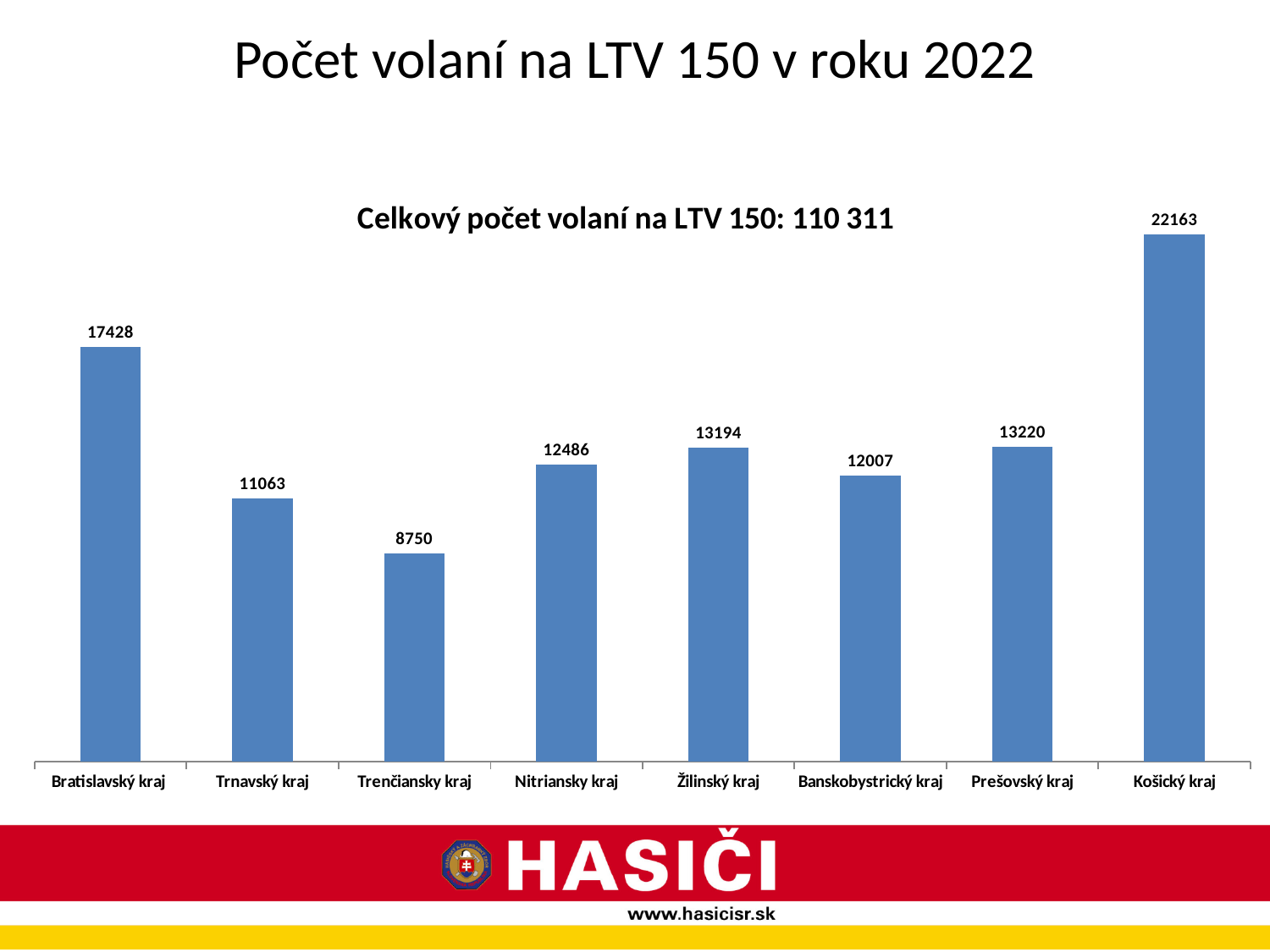
What is the value for Banskobystrický kraj? 12007 Which region has the highest number of calls? Košický kraj What is the value for Bratislavský kraj? 17428 What is the value for Trenčiansky kraj? 8750 Which region has the lowest number of calls? Trenčiansky kraj What is the difference between the values for Košický kraj and Bratislavský kraj? 4735 What is the difference between the values for Prešovský kraj and Žilinský kraj? 26 What kind of chart is shown on the slide? Bar chart Which is larger, the value for Nitriansky kraj or the value for Trnavský kraj? Nitriansky kraj What total number of calls is stated in the chart's subtitle? 110 311 What is the value for Košický kraj? 22163 How many regions are shown in the chart? 8